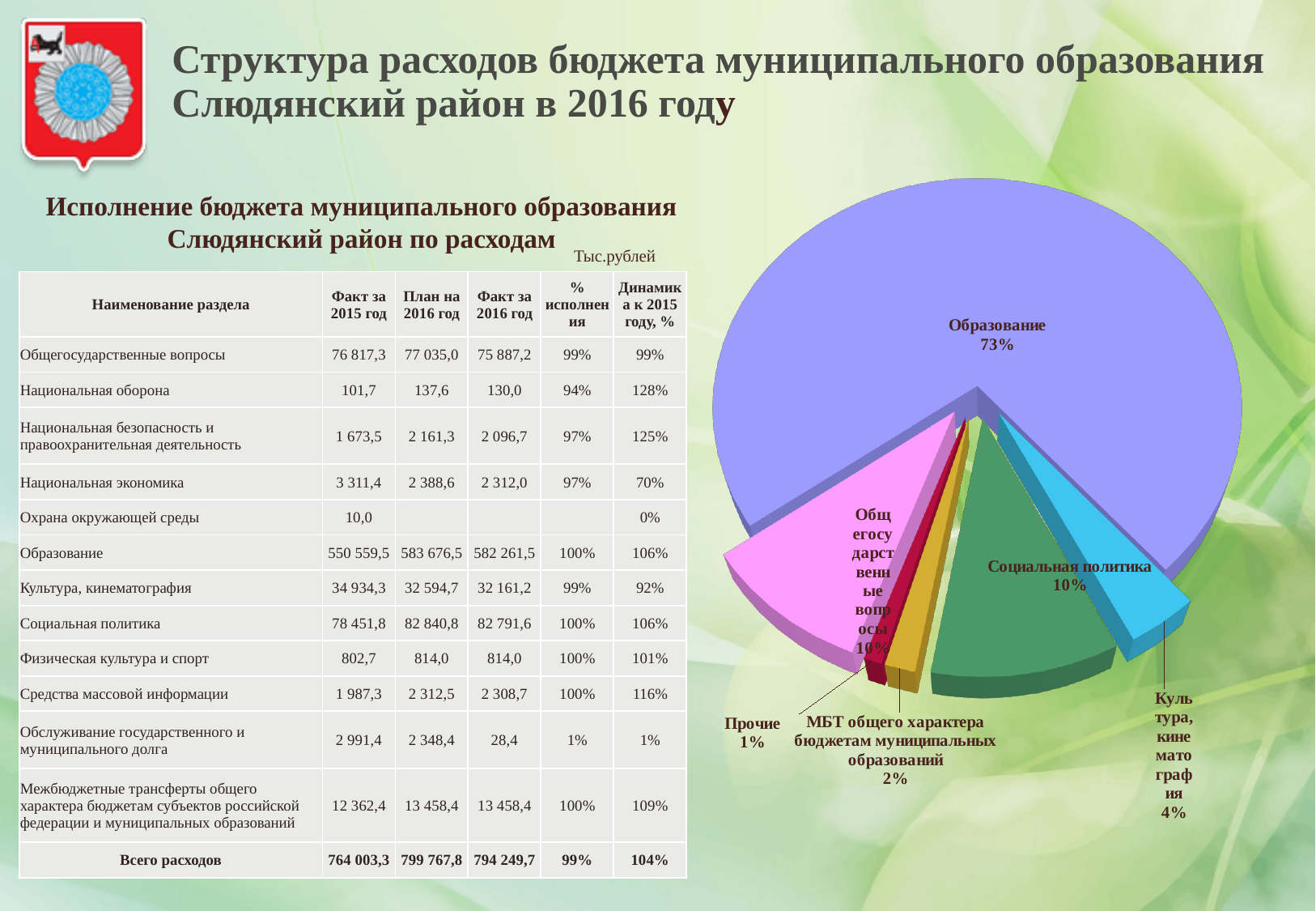
Which slice of the pie chart is the largest? Образование What share of the pie does МБТ общего характера бюджетам муниципальных образований have? 2% How many slices does the pie chart have? 6 What share of the pie does Социальная политика have? 10% Which slice of the pie chart is the smallest? Прочие What is the difference in percentage points between the Образование slice and the Социальная политика slice? 63 What share of the pie does Прочие have? 1% Which is larger in the pie chart: Социальная политика or Культура, кинематография? Социальная политика What kind of chart is shown on the slide? pie chart What colour is the Образование slice in the pie chart? purple